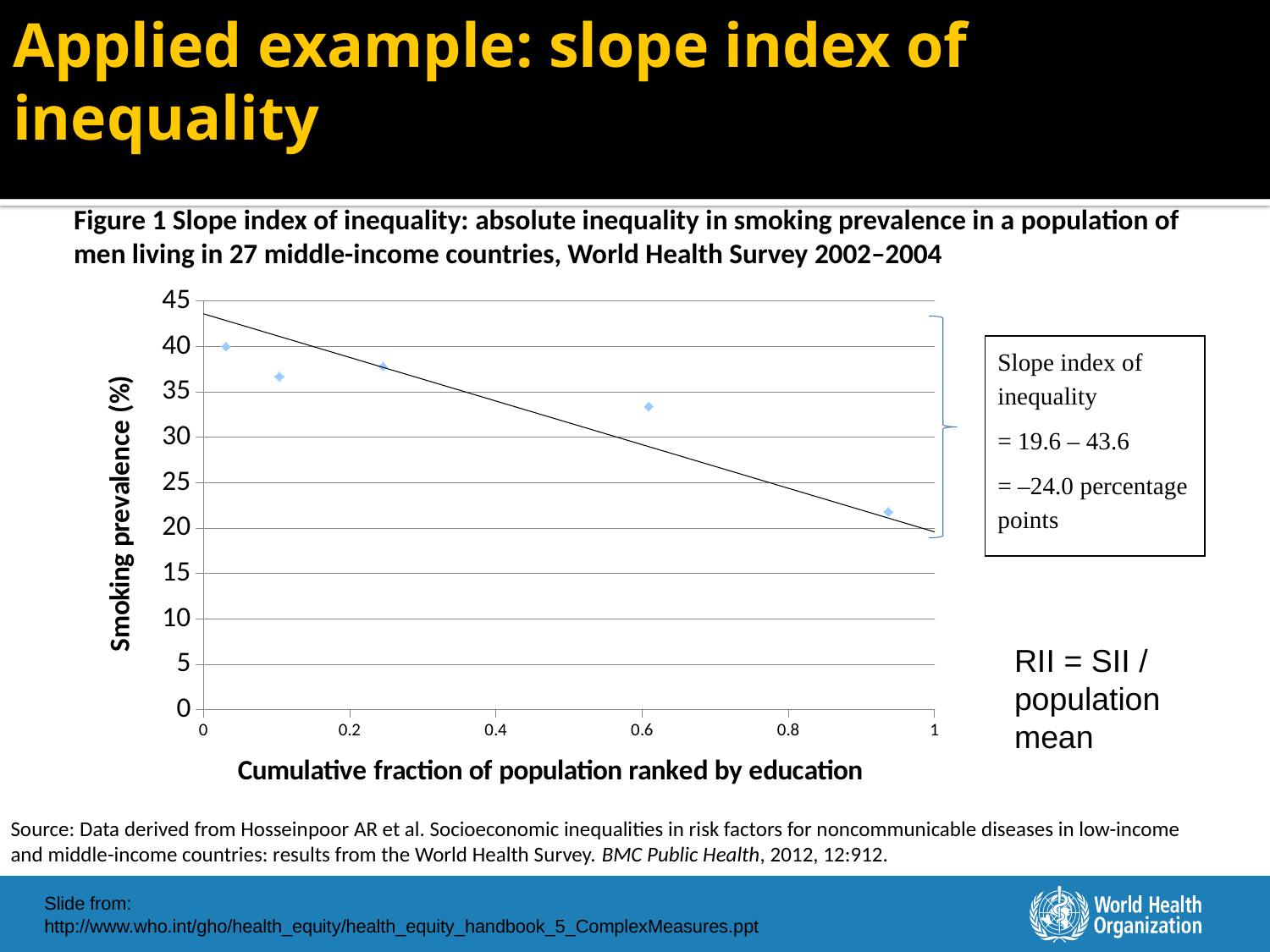
What is the title of the y axis? Smoking prevalence (%) Is the smoking prevalence for the data point near a cumulative fraction of 0.6 greater or less than 30? greater What kind of chart is shown on the slide? Scatter chart What is the title of the x axis? Cumulative fraction of population ranked by education Which data point has the highest smoking prevalence: the leftmost one or the rightmost one? The leftmost one Is the smoking prevalence for the leftmost data point (near a cumulative fraction of 0) greater or less than 35? greater How many data points are plotted on the chart? 5 Do the plotted smoking prevalence values rise or fall as the cumulative fraction of population increases along the x axis? Fall Is the smoking prevalence for the rightmost data point (near a cumulative fraction of 1) greater or less than 25? less Which data point has the lowest smoking prevalence? The rightmost point (near a cumulative fraction of 1) Which has the larger smoking prevalence: the data point near a cumulative fraction of 0.6 or the one near 1? The point near 0.6 According to the text box on the slide, what is the value of the slope index of inequality? –24.0 percentage points